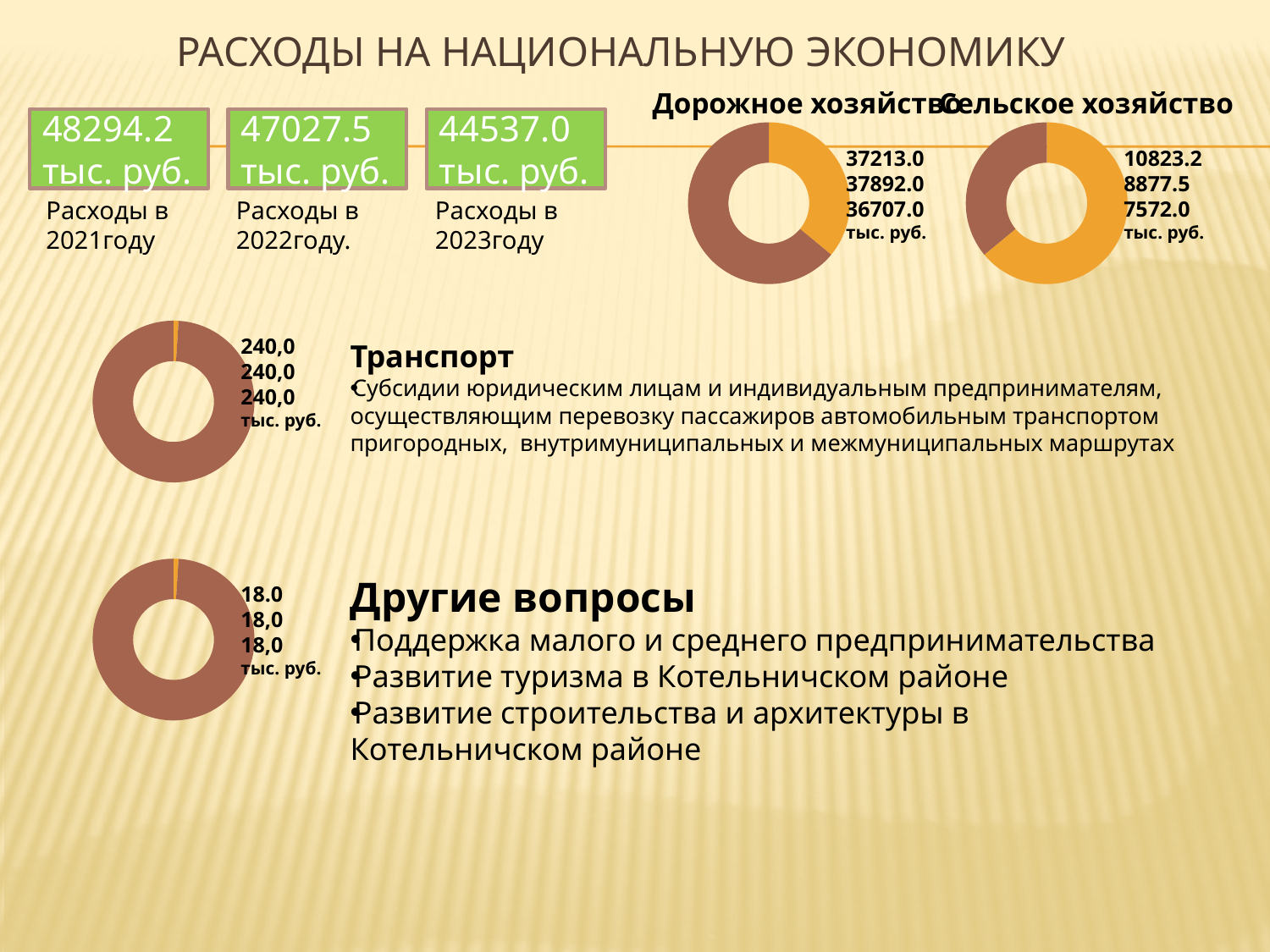
What is the title of the donut chart at the top right of the slide? Сельское хозяйство What kind of chart is used under the title 'Дорожное хозяйство'? Donut (pie) chart Which is larger: the first value listed for 'Дорожное хозяйство' (37213.0) or the first value listed for 'Сельское хозяйство' (10823.2)? Дорожное хозяйство (37213.0) In the 'Дорожное хозяйство' chart, what is the first value listed beside the donut? 37213.0 In the 'Дорожное хозяйство' chart, which of the three listed values is the largest? 37892.0 How many donut charts are shown on the slide? 4 In the 'Сельское хозяйство' chart, what is the difference between the largest listed value (10823.2) and the smallest (7572.0)? 3251.2 In the 'Дорожное хозяйство' chart, which of the three listed values is the smallest? 36707.0 What value is repeated three times beside the donut chart next to the 'Транспорт' section? 240,0 тыс. руб. What value is listed beside the donut chart next to the 'Другие вопросы' section? 18.0 тыс. руб. In the 'Сельское хозяйство' chart, what is the smallest value listed beside the donut? 7572.0 In the 'Сельское хозяйство' chart, what is the largest value listed beside the donut? 10823.2